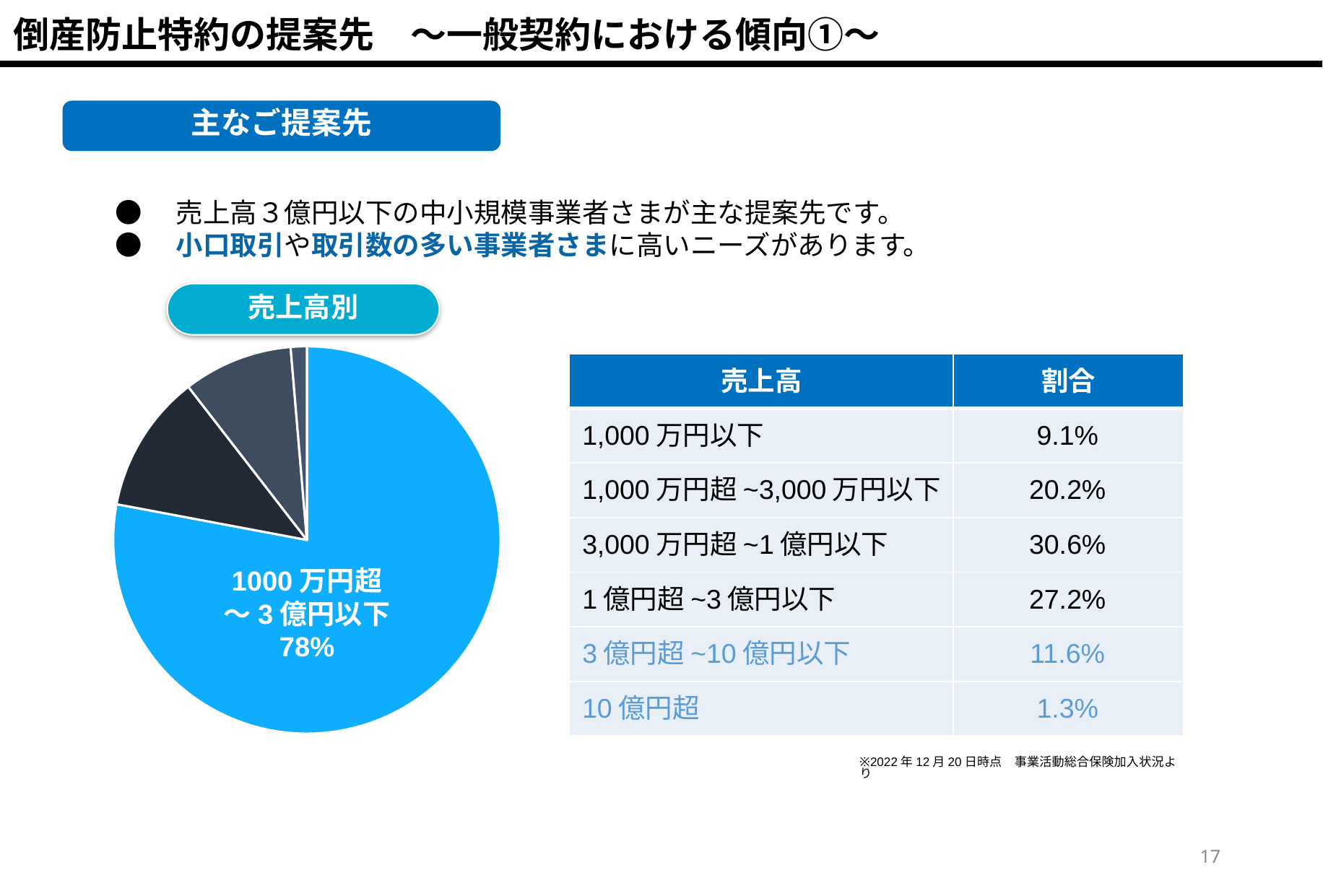
Which slice of the pie chart is the largest? 1000万円超～3億円以下 What share of the pie does the 1000万円超～3億円以下 slice represent? 78% What colour is the largest slice of the pie chart? blue What kind of chart is shown on the slide? pie chart How many slices does the pie chart have? 4 What is the title shown above the pie chart? 売上高別 Is the share of the 1000万円超～3億円以下 slice greater or less than 50%? greater